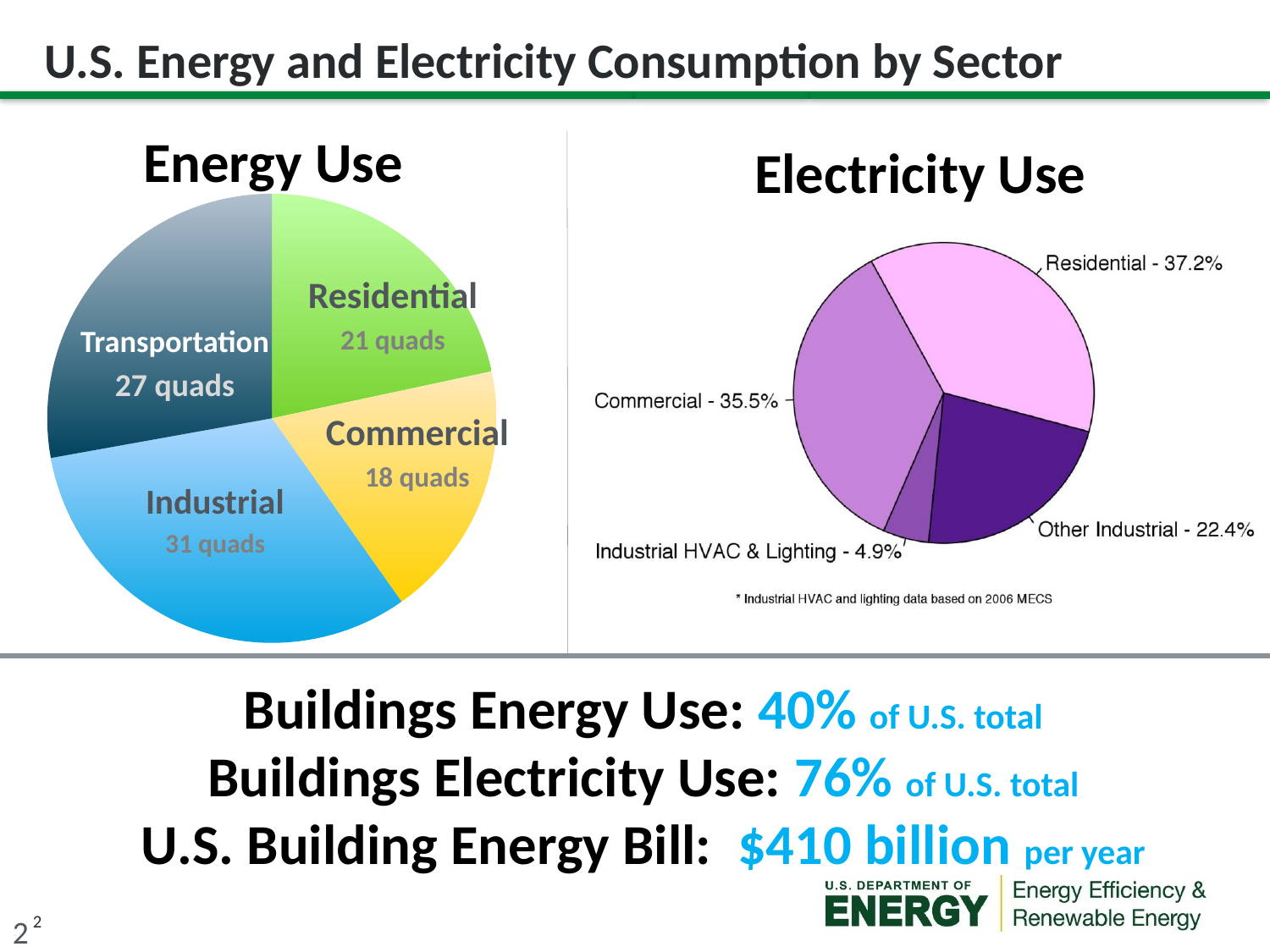
In the Energy Use chart, what is the difference in quads between Transportation and Residential? 6 quads In the Energy Use chart, which sector uses the least energy? Commercial In the Electricity Use chart, what share of electricity is used by Industrial HVAC & Lighting? 4.9% What kind of chart is the Electricity Use chart? Pie chart In the Electricity Use chart, what share of electricity is used by the Residential sector? 37.2% In the Electricity Use chart, which sector has the smallest share? Industrial HVAC & Lighting In the Energy Use chart, which sector uses the most energy? Industrial How many sectors are shown in the Energy Use chart? 4 In the Energy Use chart, how many quads does the Commercial sector use? 18 quads In the Electricity Use chart, what is the difference between the Commercial and Other Industrial shares? 13.1% In the Energy Use chart, how many quads does the Industrial sector use? 31 quads In the Energy Use chart, which uses more energy, Transportation or Industrial? Industrial